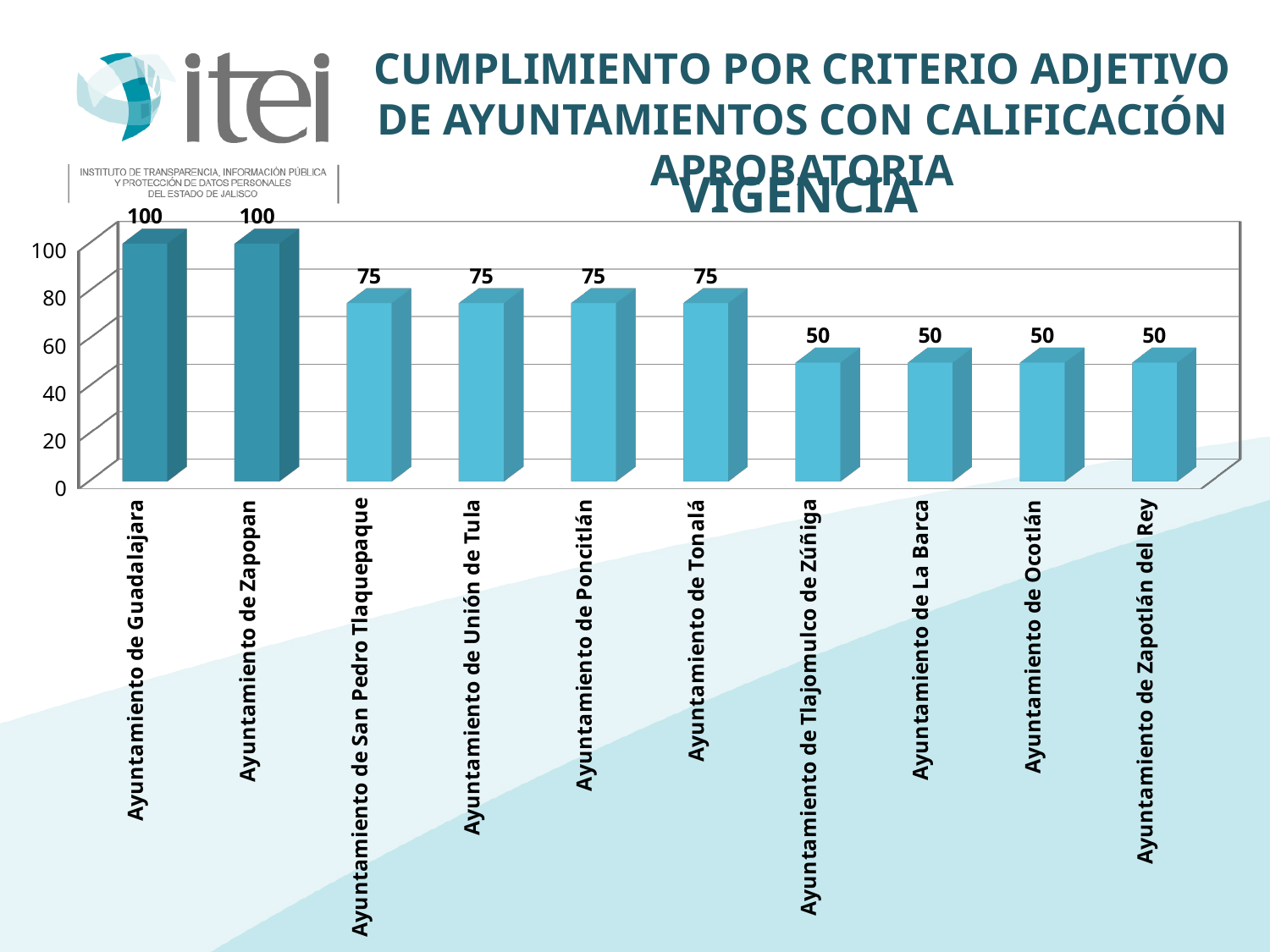
What is the chart's title? VIGENCIA What is the value for Ayuntamiento de Zapotlán del Rey? 50 What is the value for Ayuntamiento de La Barca? 50 What is the difference between the values for Ayuntamiento de Zapopan and Ayuntamiento de Tonalá? 25 How many ayuntamientos are shown in the chart? 10 What is the difference between the values for Ayuntamiento de Unión de Tula and Ayuntamiento de Ocotlán? 25 Do the values rise or fall from left to right along the x axis? fall Is the value for Ayuntamiento de Tonalá greater or less than 60? greater What is the value for Ayuntamiento de Poncitlán? 75 Which is larger, the value for Ayuntamiento de San Pedro Tlaquepaque or the value for Ayuntamiento de Tlajomulco de Zúñiga? Ayuntamiento de San Pedro Tlaquepaque What kind of chart is shown on the slide? bar chart What is the value for Ayuntamiento de Guadalajara? 100